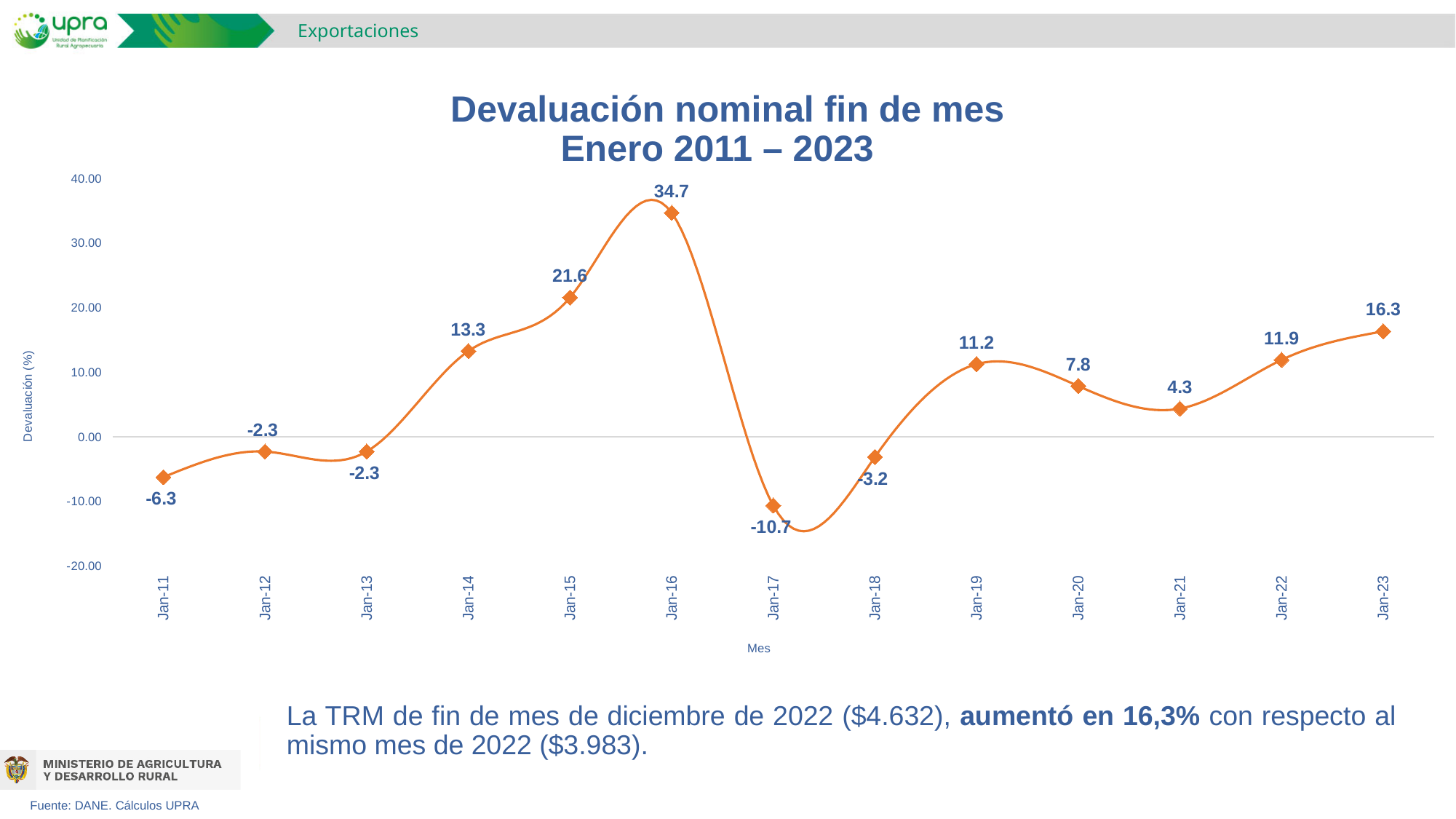
Is the value for Jan-14 greater or less than 10.00? greater What is the title of the chart? Devaluación nominal fin de mes Enero 2011 – 2023 Which month has the lowest value? Jan-17 What kind of chart is shown on the slide? line chart Which is larger, the value for Jan-19 or the value for Jan-20? Jan-19 What is the value for Jan-23? 16.3 What is the value for Jan-16? 34.7 Which month has the highest value? Jan-16 Do the values rise or fall from Jan-21 to Jan-23? rise How many data points are plotted on the chart? 13 What is the difference between the values for Jan-16 and Jan-15? 13.1 What is the value for Jan-17? -10.7